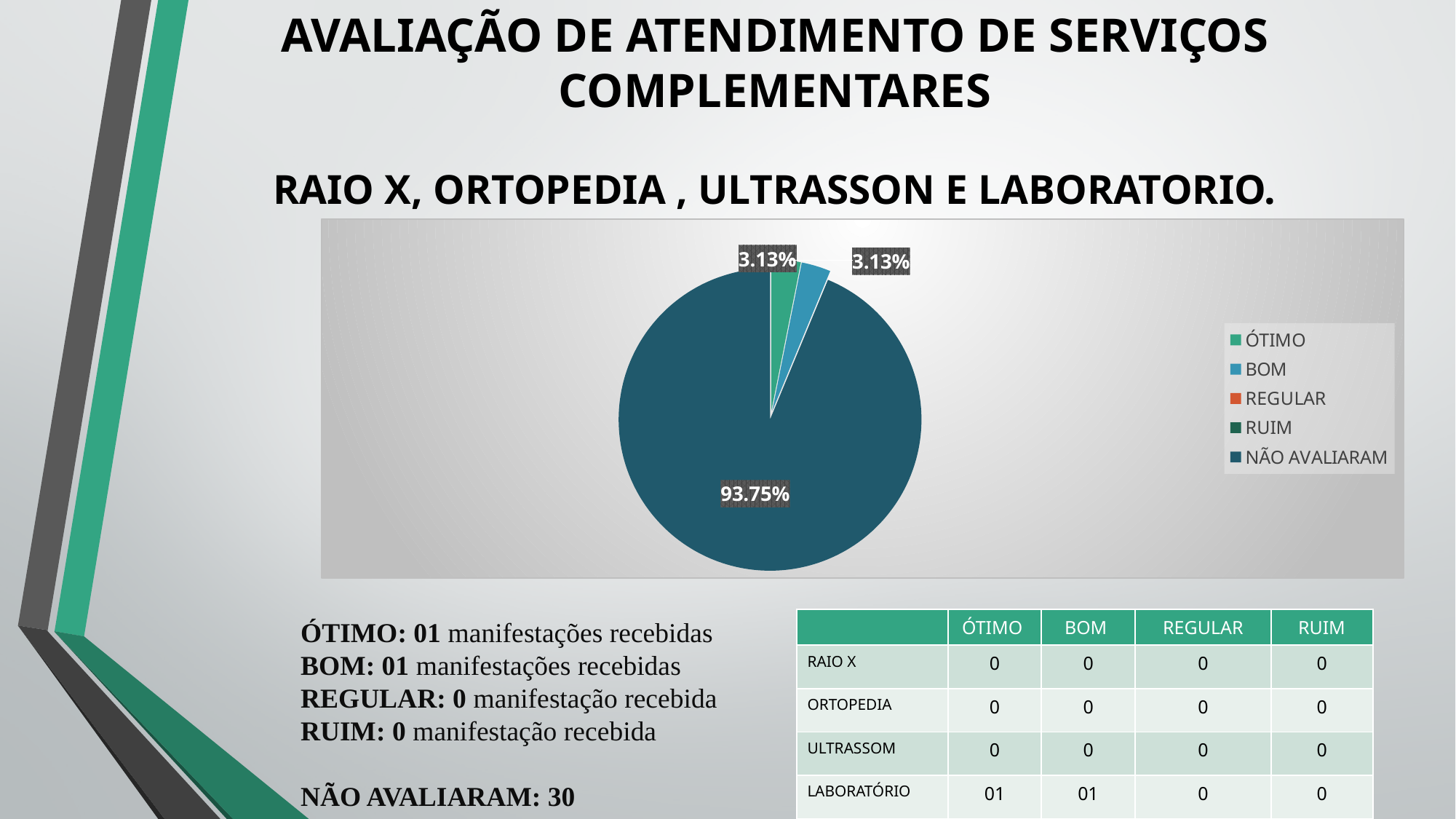
What share of the pie does BOM represent? 3.13% What share of the pie does NÃO AVALIARAM represent? 93.75% Which legend entry is shown in the darkest teal colour, matching the largest slice? NÃO AVALIARAM How many slices with data labels are visible in the pie? 3 What kind of chart is shown on the slide? pie chart Which is larger, the share for NÃO AVALIARAM or the share for ÓTIMO? NÃO AVALIARAM How many entries does the chart legend list? 5 Which category has the largest slice of the pie? NÃO AVALIARAM What share of the pie does ÓTIMO represent? 3.13% Which legend entries have no visible slice in the pie? REGULAR and RUIM What is the difference between the share for NÃO AVALIARAM and the share for BOM? 90.62% Is the share for NÃO AVALIARAM greater or less than 90%? greater